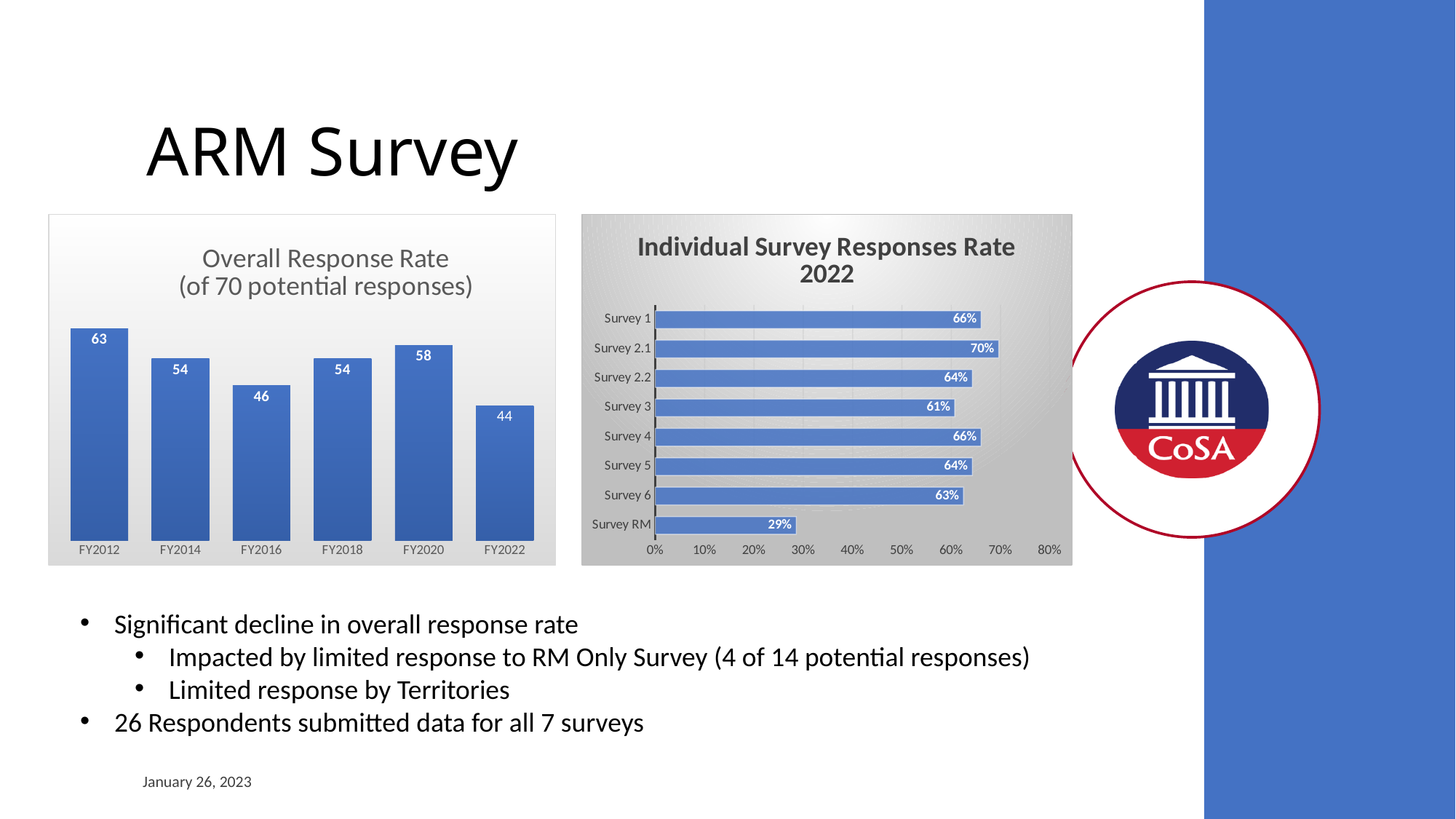
In the 'Individual Survey Responses Rate 2022' chart, which survey has the lowest response rate? Survey RM In the 'Overall Response Rate' chart, how many fiscal years are shown? 6 In the 'Individual Survey Responses Rate 2022' chart, what is the value for Survey 2.1? 70% In the 'Individual Survey Responses Rate 2022' chart, which is larger, the value for Survey 3 or the value for Survey 4? Survey 4 In the 'Overall Response Rate' chart, which fiscal year has the lowest value? FY2022 What kind of chart is the 'Individual Survey Responses Rate 2022' chart? Bar chart In the 'Overall Response Rate' chart, what is the value for FY2012? 63 In the 'Overall Response Rate' chart, which fiscal year has the highest value? FY2012 In the 'Individual Survey Responses Rate 2022' chart, what is the value for Survey RM? 29% In the 'Overall Response Rate' chart, what is the difference between the FY2012 and FY2022 values? 19 In the 'Individual Survey Responses Rate 2022' chart, how many surveys are listed? 8 In the 'Overall Response Rate' chart, what is the value for FY2022? 44